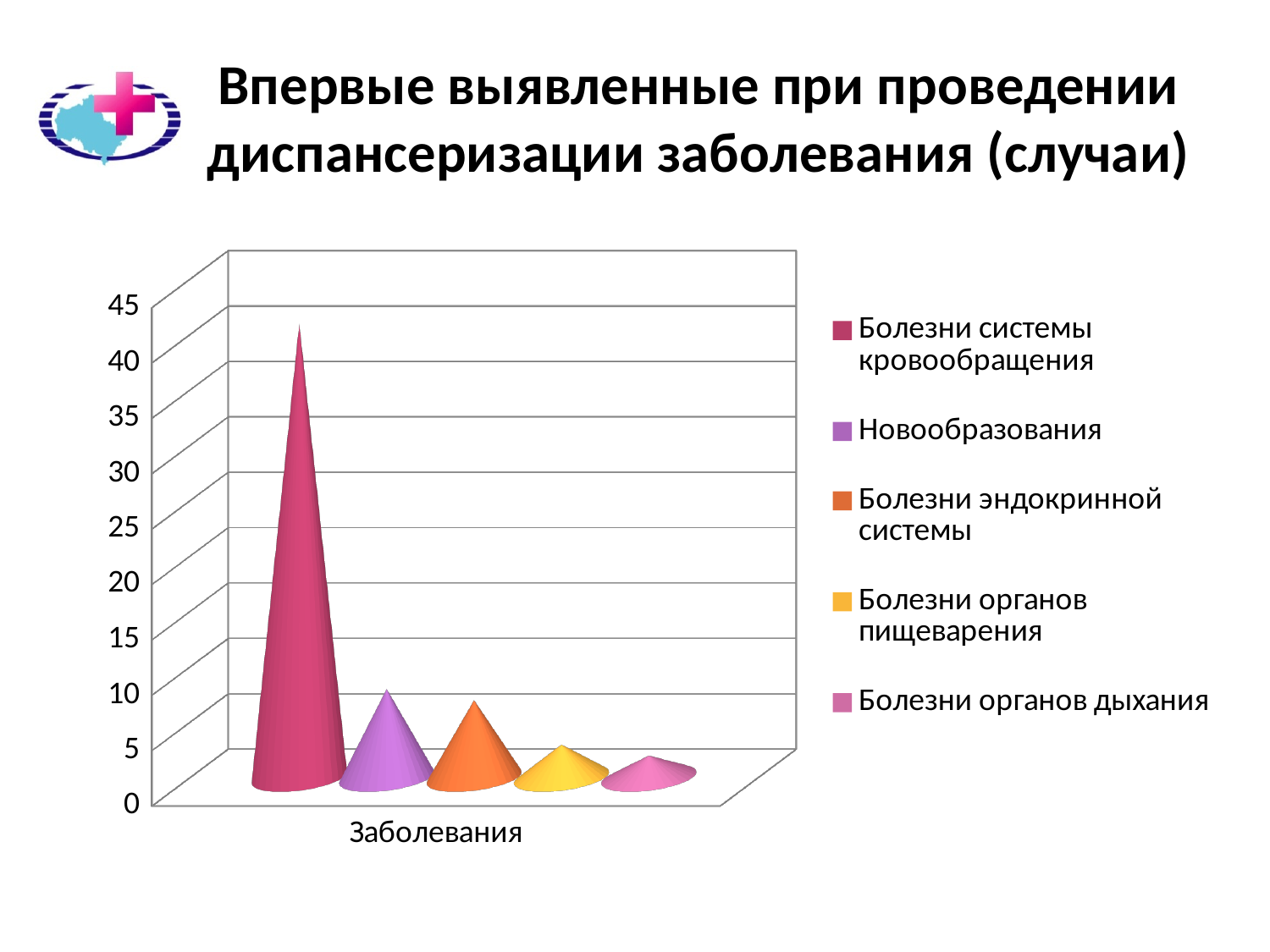
Which series has the lowest value in the chart? Болезни органов дыхания Is the value for Новообразования greater or less than 15? less Which is larger: the value for Новообразования or for Болезни органов пищеварения? Новообразования What is the label of the category on the x axis? Заболевания Which series has the highest value in the chart? Болезни системы кровообращения Which is larger: the value for Болезни эндокринной системы or for Болезни органов дыхания? Болезни эндокринной системы How many series does the legend list? 5 What kind of chart is shown on the slide? bar chart Is the value for Болезни органов пищеварения greater or less than 10? less Is the value for Болезни системы кровообращения greater or less than 30? greater Which is larger: the value for Болезни системы кровообращения or for Новообразования? Болезни системы кровообращения